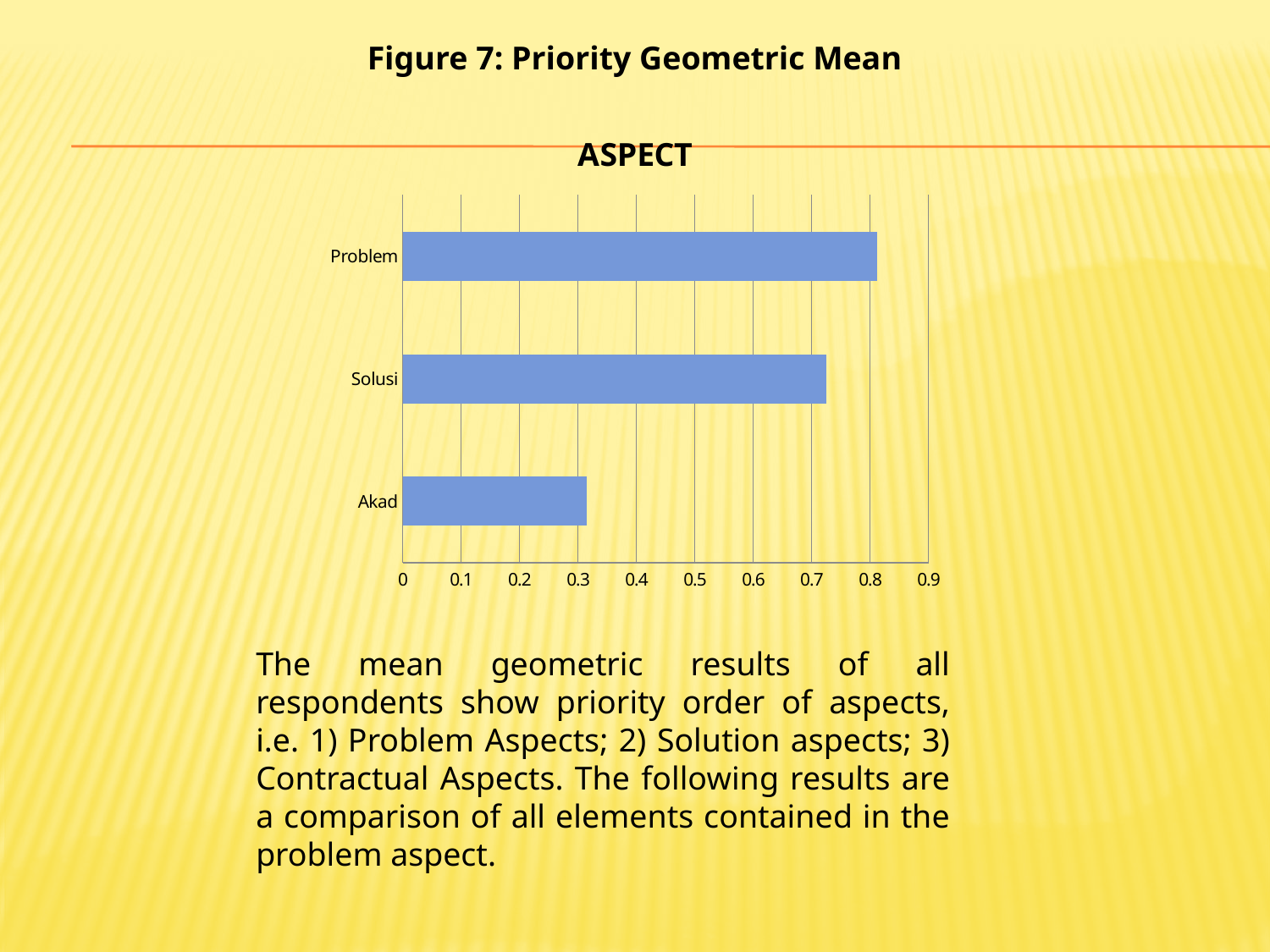
Which is larger, the value for Solusi or the value for Akad? Solusi Is the value for Akad greater or less than 0.4? less Which category has the lowest value? Akad Is the value for Akad greater or less than 0.2? greater Is the value for Solusi greater or less than 0.6? greater What kind of chart is shown on the slide? bar chart What is the title of the chart? ASPECT How many categories are plotted in the chart? 3 Which category has the highest value? Problem Which is larger, the value for Problem or the value for Solusi? Problem